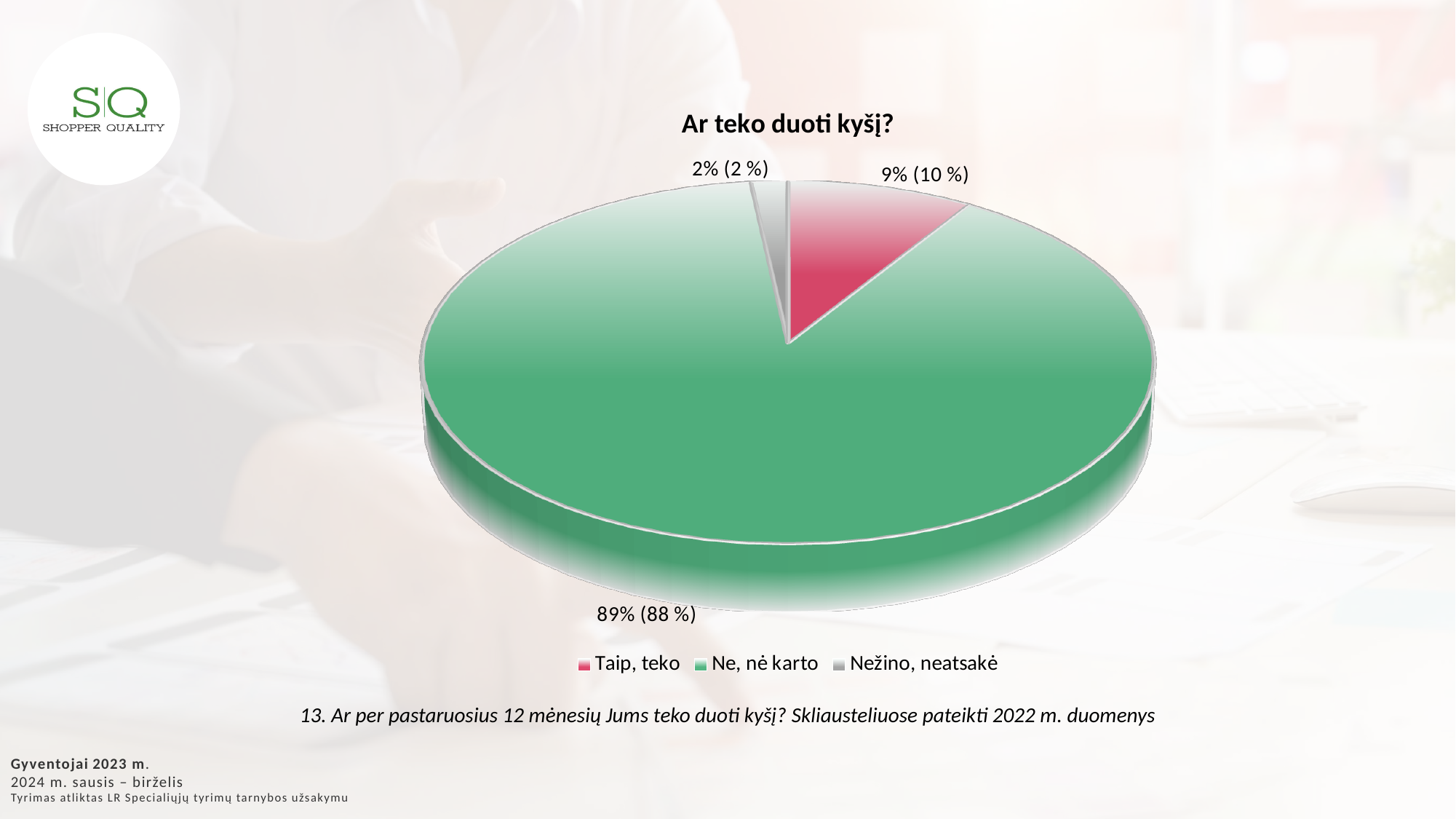
What is the 2022 value (in parentheses) for 'Taip, teko'? 10 % What data label is shown for the 'Nežino, neatsakė' slice? 2% (2 %) What data label is shown for the 'Ne, nė karto' slice? 89% (88 %) Which category has the smallest share of the pie? Nežino, neatsakė What data label is shown for the 'Taip, teko' slice? 9% (10 %) How many slices does the pie chart have? 3 How many entries does the legend list? 3 What is the difference in percentage points between the 'Ne, nė karto' share (89%) and the 'Taip, teko' share (9%)? 80 Which category has the largest share of the pie? Ne, nė karto What type of chart is shown on the slide? pie chart Which is larger, the share for 'Taip, teko' or for 'Nežino, neatsakė'? Taip, teko What is the title of the chart? Ar teko duoti kyšį?